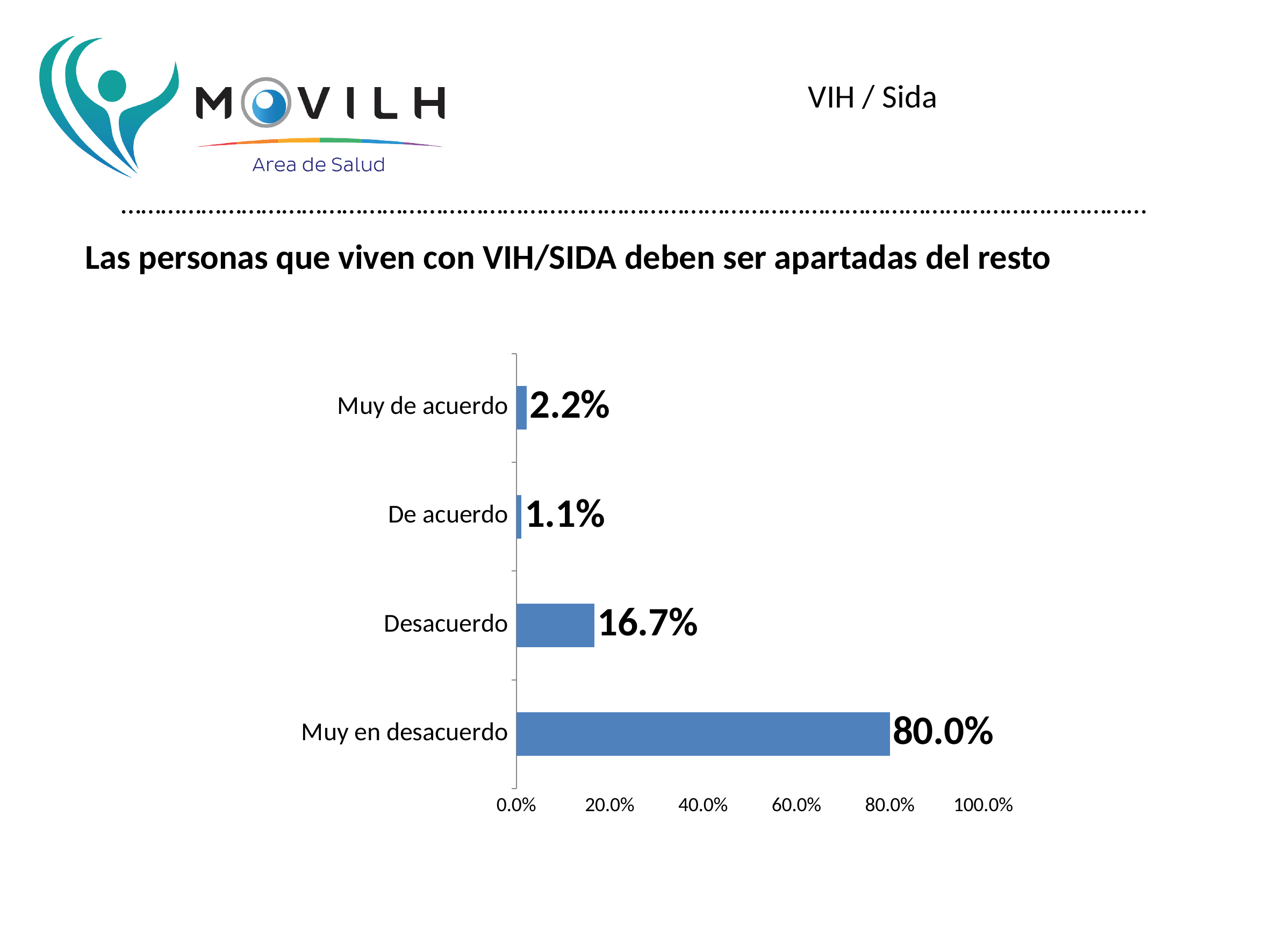
What is the title of the chart on the slide? Las personas que viven con VIH/SIDA deben ser apartadas del resto Which category has the lowest value? De acuerdo What is the value for Desacuerdo? 16.7% What is the value for Muy de acuerdo? 2.2% What kind of chart is shown on the slide? bar chart What is the value for De acuerdo? 1.1% Which is larger, the value for Muy de acuerdo or the value for De acuerdo? Muy de acuerdo How many categories are shown in the chart? 4 Is the value for Desacuerdo greater or less than 20.0%? less Which category has the highest value? Muy en desacuerdo What is the difference between the values for Muy en desacuerdo and Desacuerdo? 63.3% What is the value for Muy en desacuerdo? 80.0%